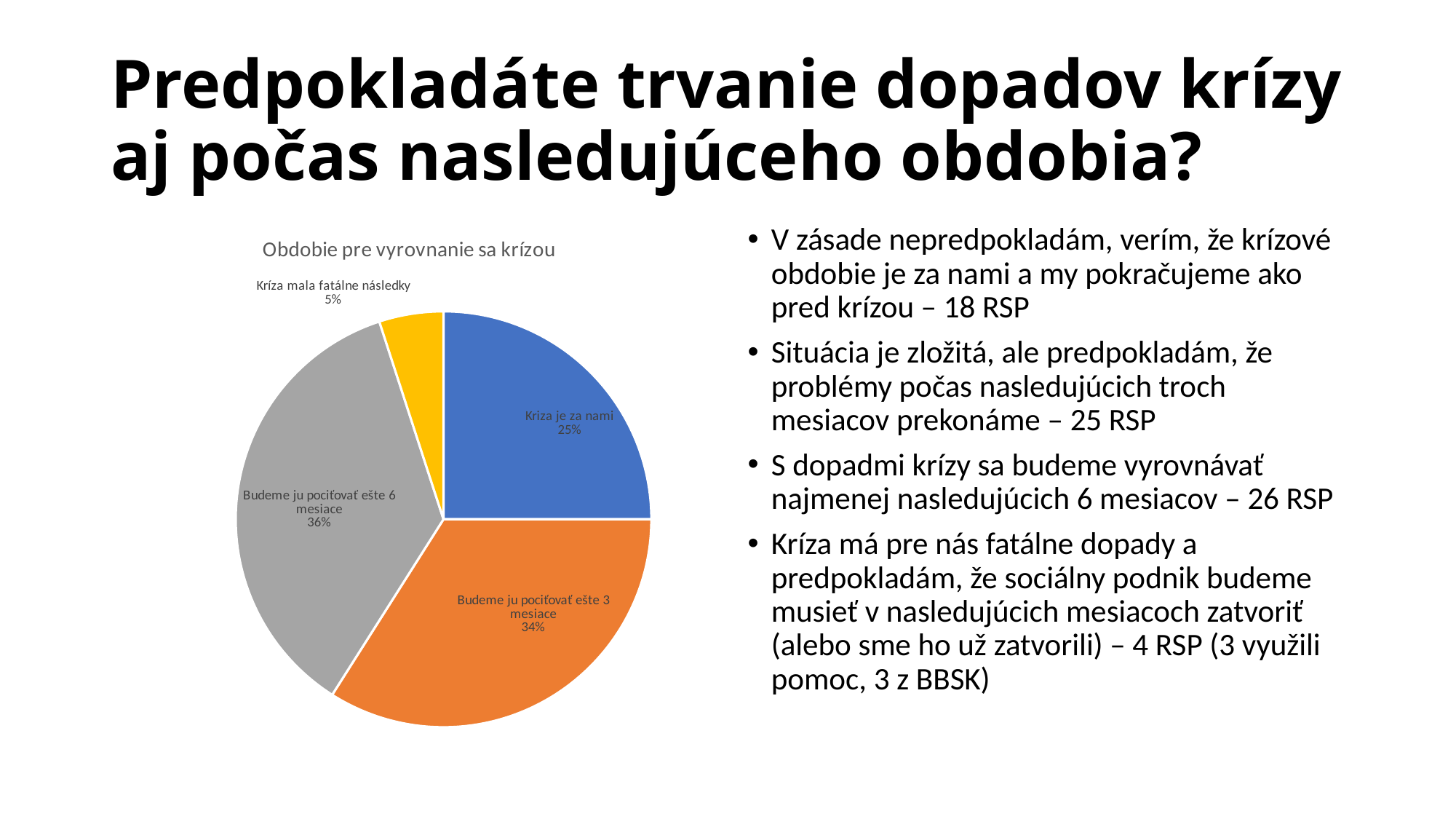
Which category has the largest slice of the pie? Budeme ju pociťovať ešte 6 mesiace What share of the pie does "Kríza mala fatálne následky" represent? 5% Which category has the smallest slice of the pie? Kríza mala fatálne následky What share of the pie does "Budeme ju pociťovať ešte 6 mesiace" represent? 36% Which is larger: the slice for "Kríza je za nami" or the slice for "Kríza mala fatálne následky"? Kríza je za nami What colour is the slice for "Kríza mala fatálne následky"? yellow What share of the pie does "Kríza je za nami" represent? 25% What is the difference in percentage points between "Budeme ju pociťovať ešte 6 mesiace" and "Kríza je za nami"? 11 How many slices does the pie chart have? 4 What kind of chart is shown on the slide? pie chart What is the title of the chart? Obdobie pre vyrovnanie sa krízou